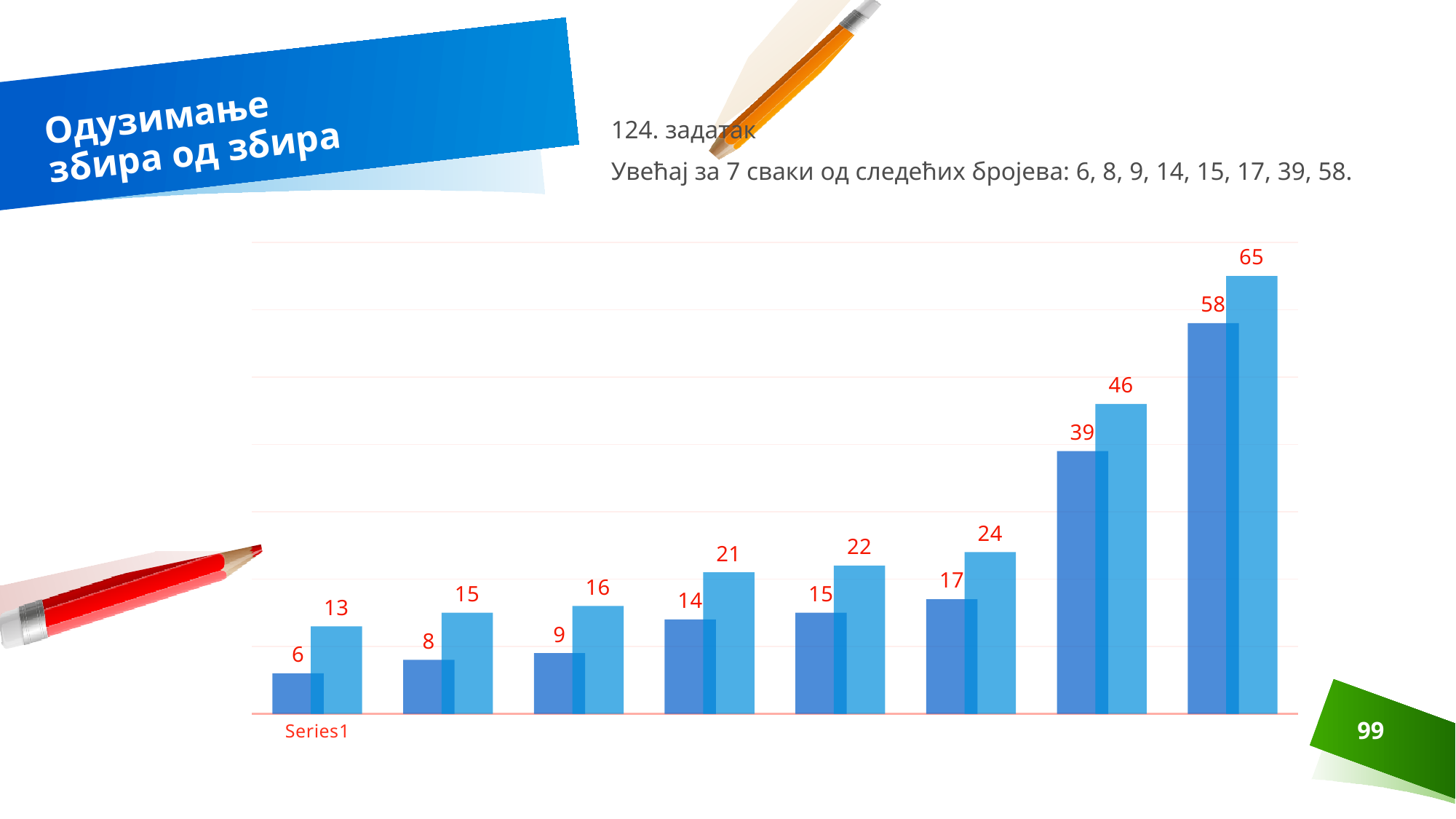
Which data label is the lowest value in the chart? 6 Which data label is the highest value in the chart? 65 What is the only category label shown on the x axis of the chart? Series1 Do the values of the darker blue bars rise or fall from left to right across the chart? rise What is the value labelled on the lighter blue bar in the rightmost group? 65 What is the value labelled on the darker blue bar in the fourth group from the left? 14 What is the difference between the lighter blue bar (46) and the darker blue bar (39) in the seventh group from the left? 7 What is the value labelled on the lighter blue bar in the leftmost group (labelled Series1)? 13 What is the value labelled on the darker blue bar in the leftmost group (labelled Series1)? 6 Which is larger in the rightmost group: the darker blue bar or the lighter blue bar? the lighter blue bar How many groups of bars are plotted in the chart? 8 What kind of chart is shown on the slide? bar chart